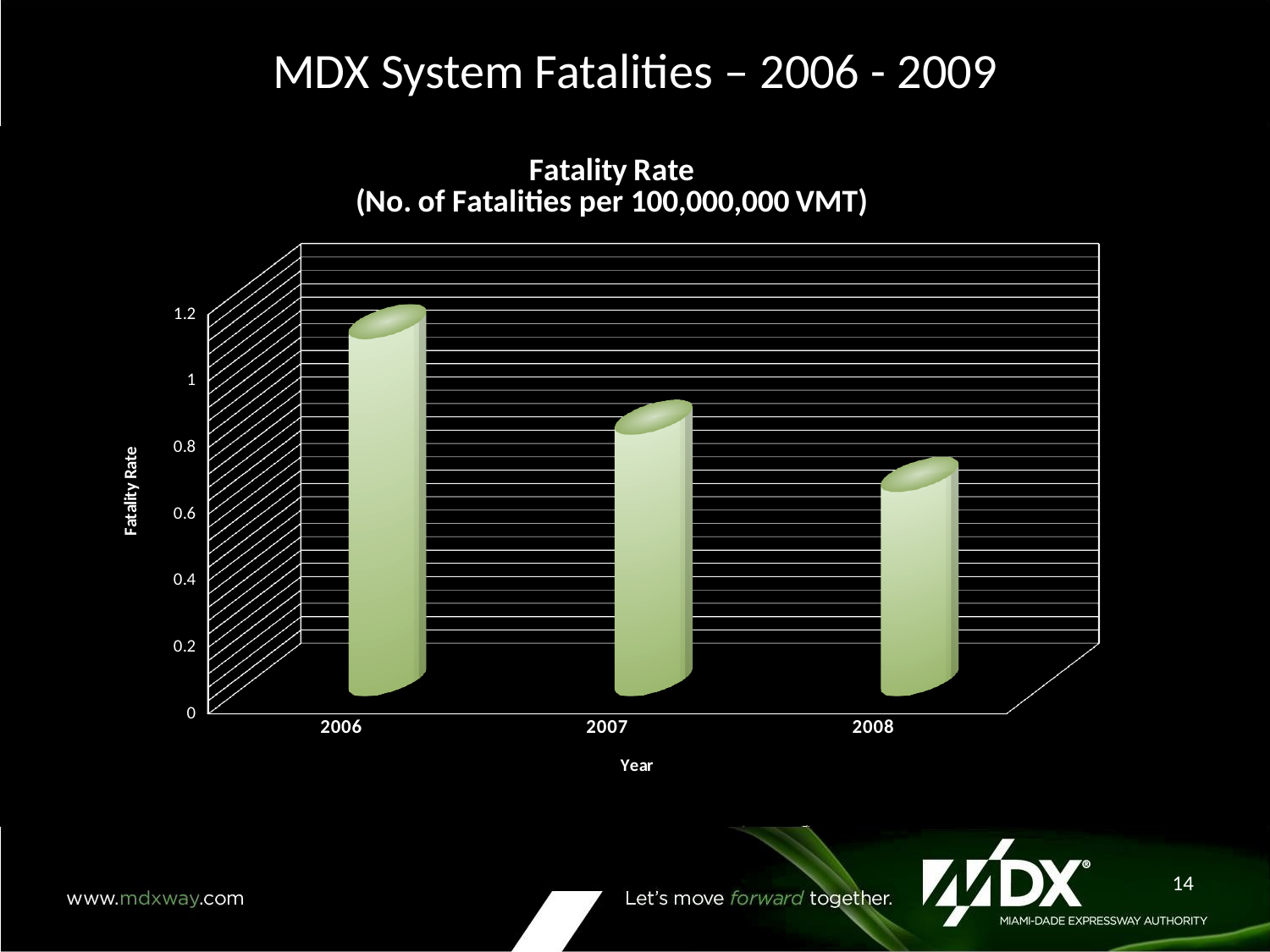
Is the fatality rate for 2006 greater or less than 0.8? greater What kind of chart is shown on the slide? bar chart Do the fatality rates rise or fall from 2006 to 2008? fall How many years are plotted in the Fatality Rate chart? 3 What is the label of the x axis? Year Is the fatality rate for 2008 greater or less than 0.4? greater Which year has the lowest fatality rate? 2008 Which year has a higher fatality rate, 2007 or 2008? 2007 Which year has the highest fatality rate? 2006 Is the fatality rate for 2008 greater or less than 0.8? less What is the title of the chart? Fatality Rate (No. of Fatalities per 100,000,000 VMT)